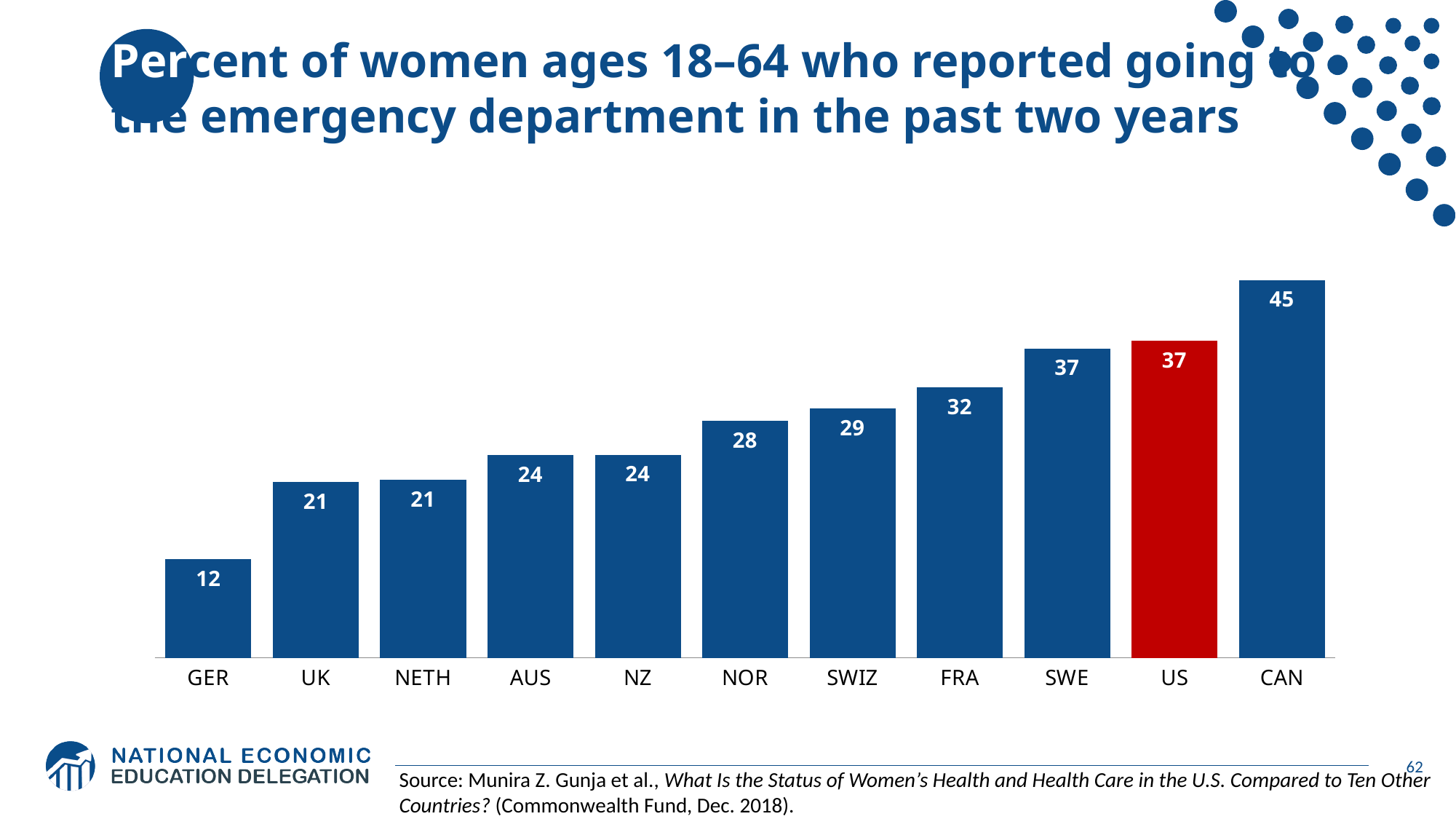
Which country has the highest value? CAN What is the value for GER? 12 What is the difference between the values for CAN and the US? 8 Which country has the lowest value? GER What is the difference between the values for SWE and GER? 25 How many countries are shown in the chart? 11 What kind of chart is shown on the slide? Bar chart Which country's bar is coloured red? US What is the value for the US? 37 What is the value for FRA? 32 Do the values rise or fall from left to right along the x axis? Rise Which has a larger value, NOR or FRA? FRA